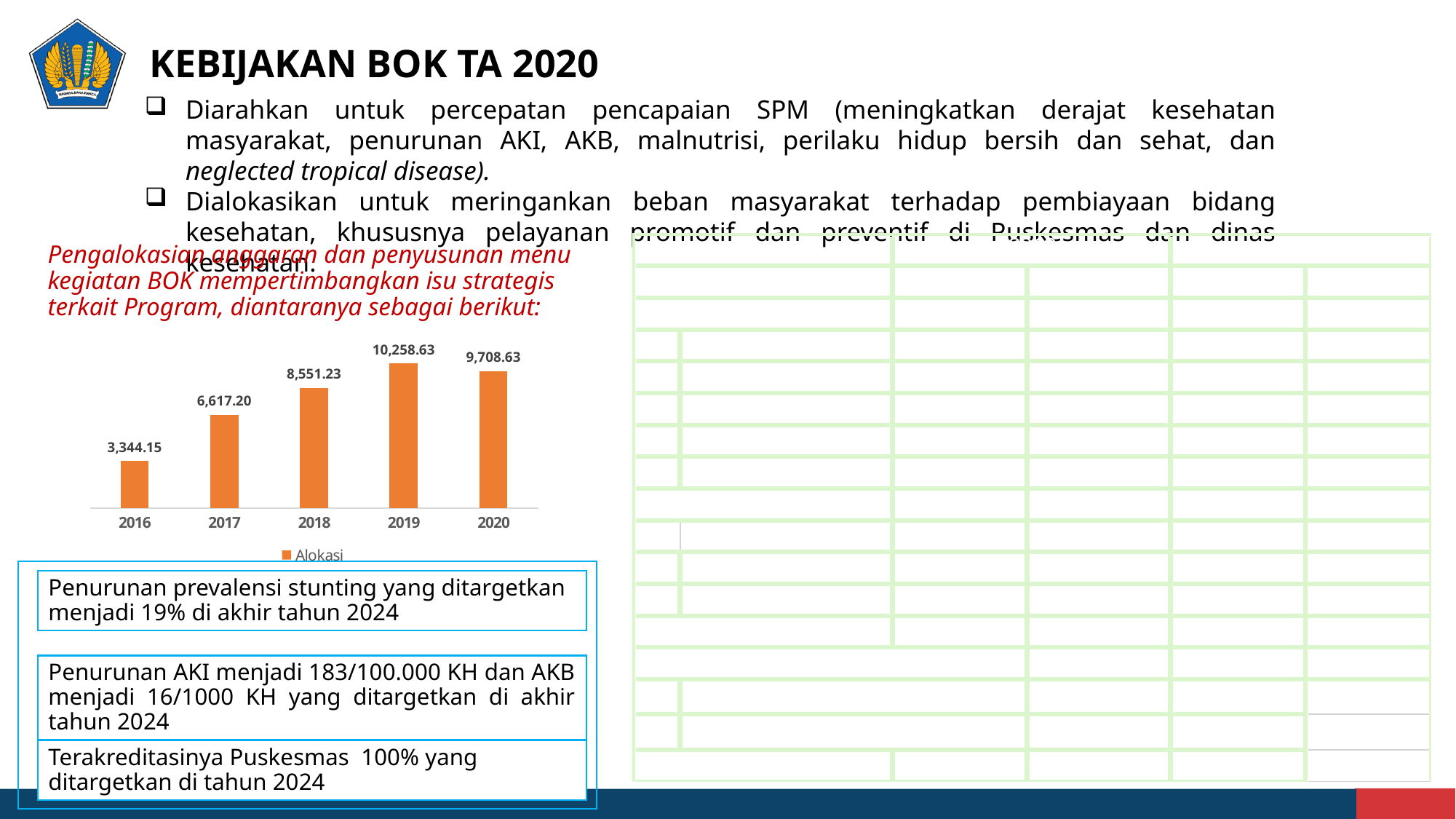
What kind of chart is shown on the slide? bar chart How many years are shown on the x axis of the chart? 5 What is the difference between the Alokasi values for 2017 and 2016? 3,273.05 Which year has the lowest Alokasi value? 2016 Which year has the highest Alokasi value? 2019 What is the Alokasi value for 2018? 8,551.23 What is the Alokasi value for 2020? 9,708.63 What is the Alokasi value for 2019? 10,258.63 What is the Alokasi value for 2016? 3,344.15 How many series does the chart legend list? 1 Which is larger, the Alokasi value for 2018 or for 2020? 2020 What is the difference between the Alokasi values for 2019 and 2020? 550.00